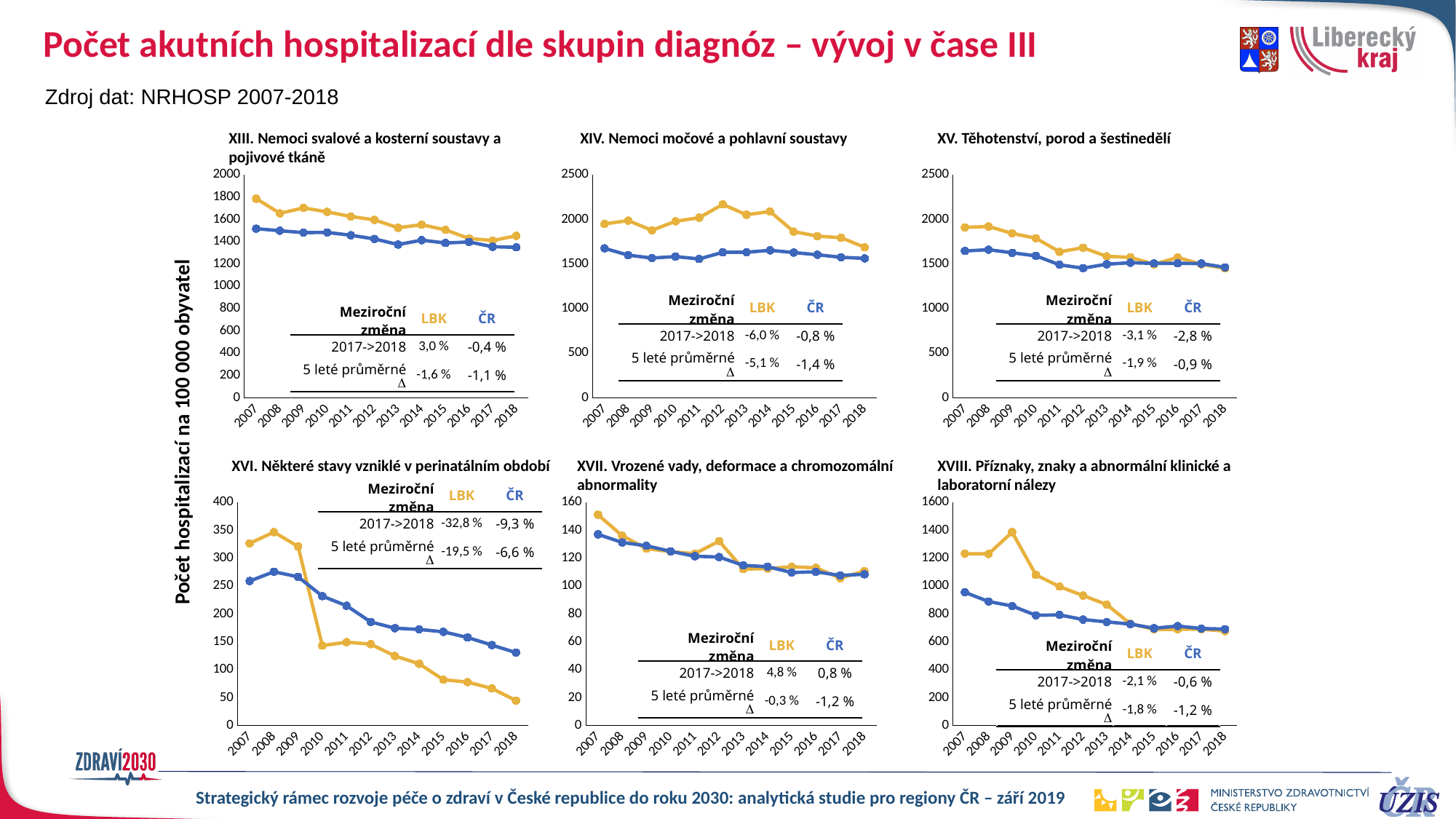
In the chart 'XIV. Nemoci močové a pohlavní soustavy', what is the ČR 5 leté průměrné Δ? -1,4 % How many years are shown on the x axis of the chart 'XV. Těhotenství, porod a šestinedělí'? 12 In the chart 'XVI. Některé stavy vzniklé v perinatálním období', is the LBK value for 2010 greater or less than 200? less How many series does each chart on the slide plot, according to the LBK/ČR labels? 2 In the chart 'XVI. Některé stavy vzniklé v perinatálním období', which series has the higher value in 2007, LBK or ČR? LBK In the chart 'XVI. Některé stavy vzniklé v perinatálním období', what is the LBK meziroční změna 2017->2018? -32,8 % In the chart 'XVI. Některé stavy vzniklé v perinatálním období', does the ČR series rise or fall from 2008 to 2018? fall In the chart 'XVIII. Příznaky, znaky a abnormální klinické a laboratorní nálezy', in which year does the LBK series reach its highest value? 2009 In the chart 'XIII. Nemoci svalové a kosterní soustavy a pojivové tkáně', what is the LBK meziroční změna 2017->2018? 3,0 % In the chart 'XIV. Nemoci močové a pohlavní soustavy', is the LBK value for 2012 greater or less than 2000? greater What kind of chart is used for 'XIII. Nemoci svalové a kosterní soustavy a pojivové tkáně'? line chart In the chart 'XVIII. Příznaky, znaky a abnormální klinické a laboratorní nálezy', is the LBK value for 2009 greater or less than 1200? greater